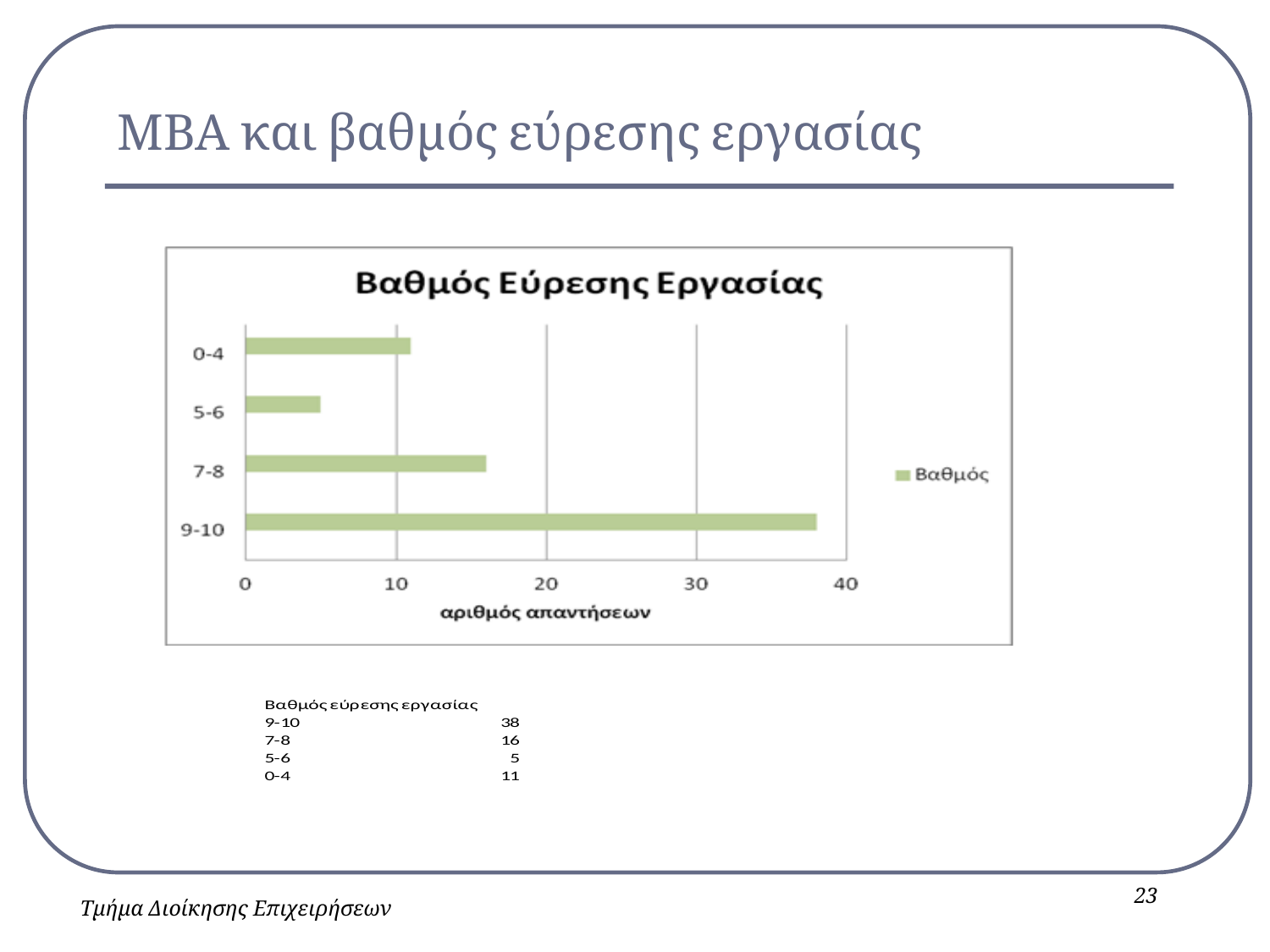
What is the value for the 5-6 category? 5 What is the value for the 9-10 category? 38 What is the value for the 0-4 category? 11 Which category has the highest value? 9-10 What kind of chart is shown on the slide? bar chart Which is larger, the value for 0-4 or the value for 5-6? 0-4 What is the difference between the values for 9-10 and 7-8? 22 How many categories does the chart show? 4 What is the title of the chart? Βαθμός Εύρεσης Εργασίας What is the value for the 7-8 category? 16 How many series does the legend list? 1 Which category has the lowest value? 5-6